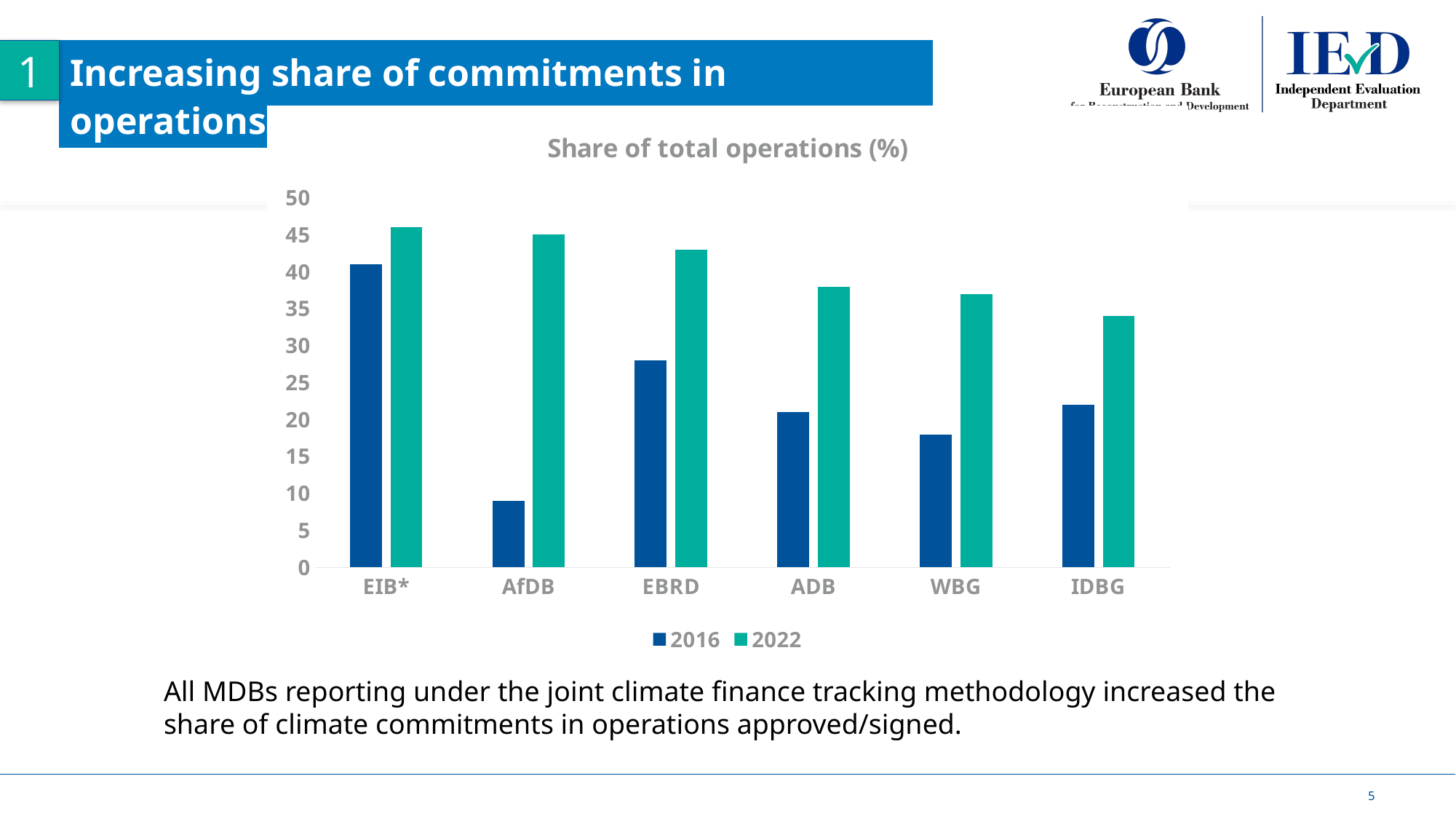
Which institution has the lowest 2016 value? AfDB Is the 2022 value for WBG greater or less than 35? greater What is the title of the chart? Share of total operations (%) What kind of chart is shown on the slide? bar chart How many series does the legend list? 2 Which is larger, the 2016 value for EBRD or the 2016 value for ADB? EBRD Is the 2022 value for EBRD greater or less than 40? greater Is the 2016 value for EIB* greater or less than 40? greater Which institution has the lowest 2022 value? IDBG Which institution has the highest 2016 value? EIB* How many institutions (categories) are shown on the x axis? 6